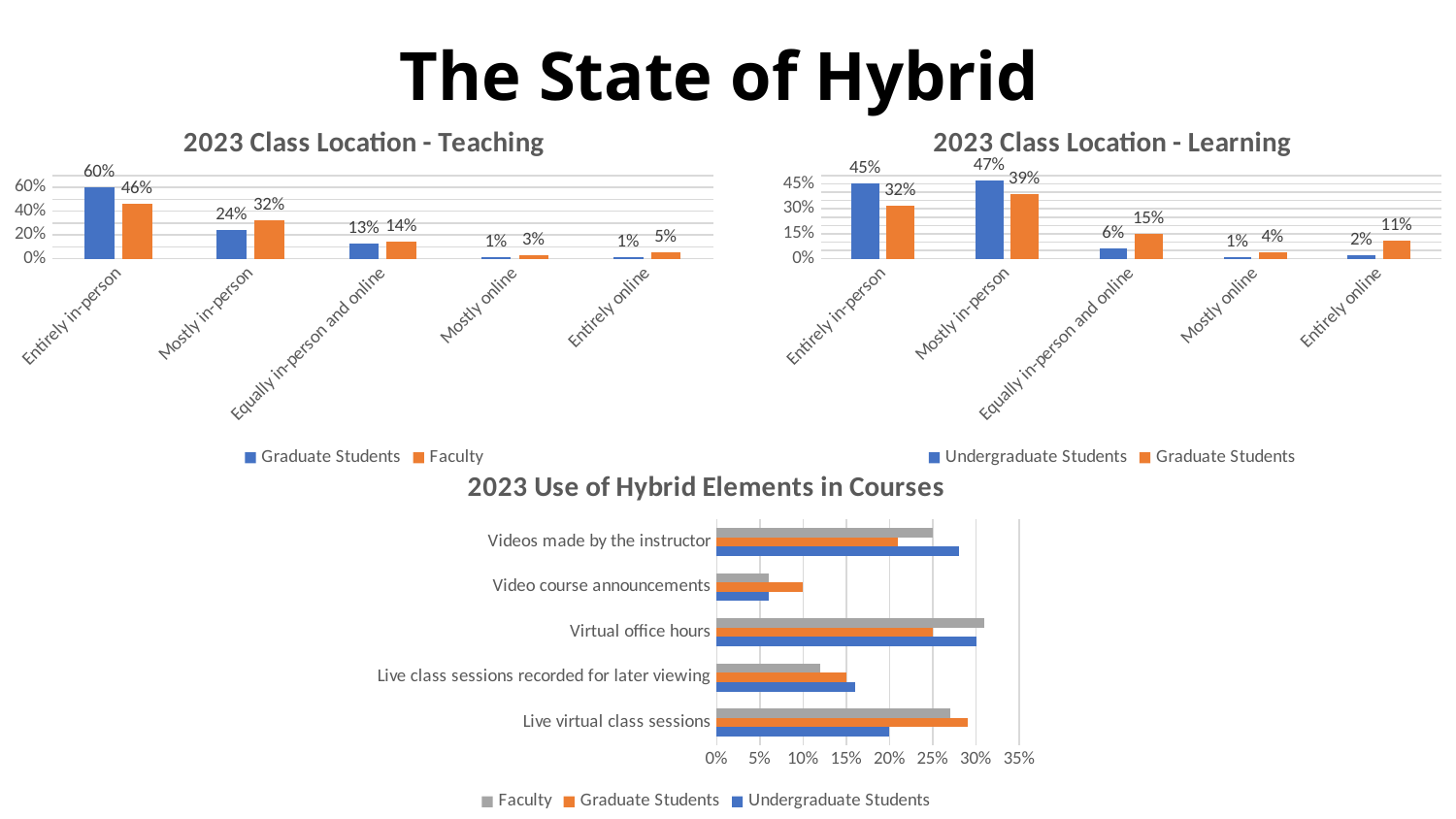
How many series does the legend of the '2023 Use of Hybrid Elements in Courses' chart list? 3 In the '2023 Class Location - Learning' chart, what is the Graduate Students value for 'Equally in-person and online'? 15% In the '2023 Class Location - Teaching' chart, what is the Faculty value for 'Mostly in-person'? 32% In the '2023 Use of Hybrid Elements in Courses' chart, is the Undergraduate Students value for 'Video course announcements' greater or less than 10%? less In the '2023 Class Location - Teaching' chart, what is the difference between the Faculty and Graduate Students values for 'Entirely online'? 4% In the '2023 Class Location - Learning' chart, which category has the lowest Undergraduate Students value? Mostly online What kind of chart is '2023 Use of Hybrid Elements in Courses'? Bar chart In the '2023 Class Location - Teaching' chart, what is the value for Graduate Students in the 'Entirely in-person' category? 60% In the '2023 Class Location - Learning' chart, what is the value for Undergraduate Students in 'Mostly in-person'? 47% How many categories are shown in the '2023 Use of Hybrid Elements in Courses' chart? 5 In the '2023 Class Location - Teaching' chart, which category has the highest Faculty value? Entirely in-person In the '2023 Class Location - Learning' chart, which is larger for 'Entirely online': Undergraduate Students or Graduate Students? Graduate Students